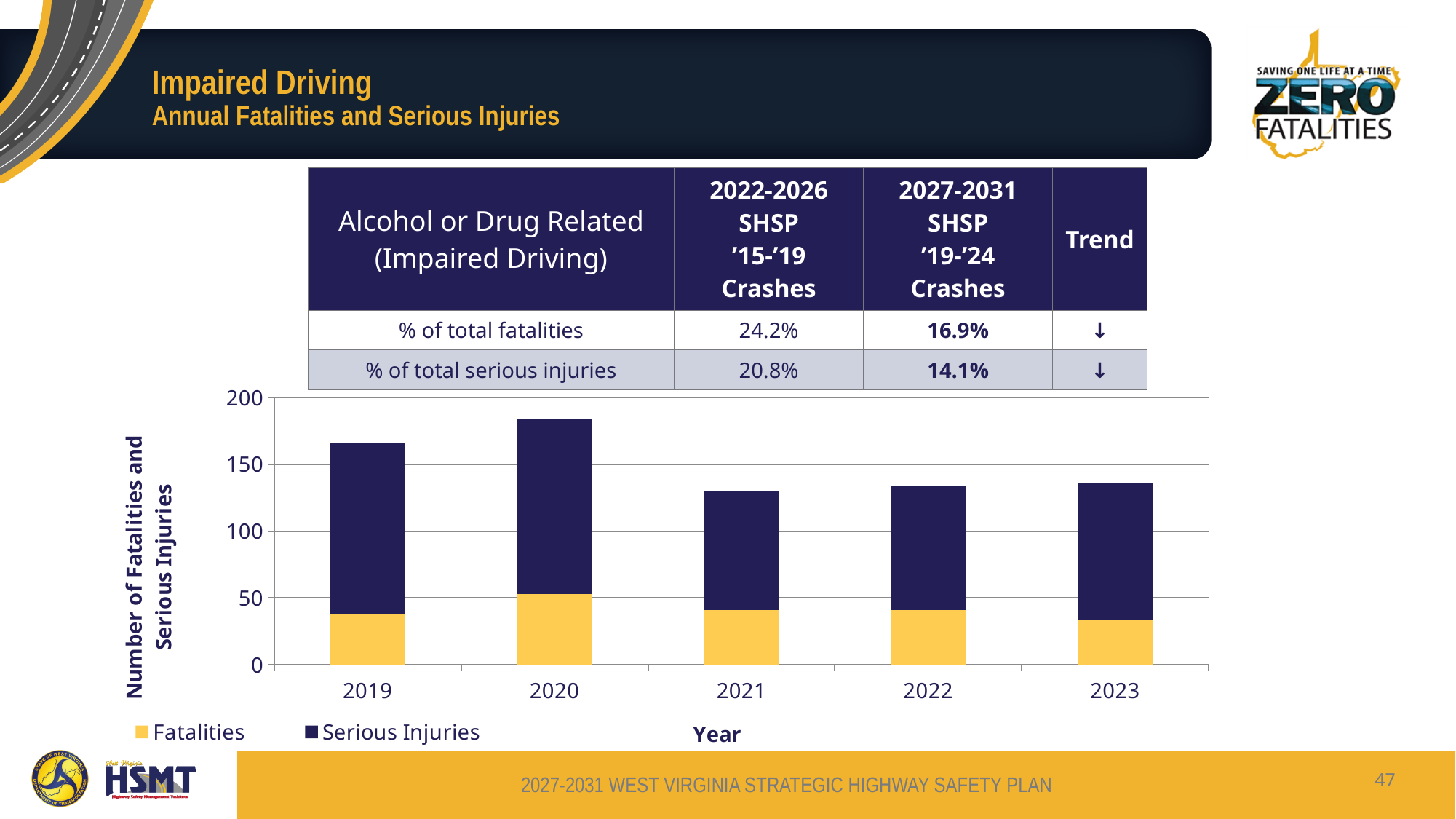
What kind of chart is shown on the slide? Stacked bar chart Which year has the tallest stacked bar (highest total of fatalities and serious injuries)? 2020 Is the number of fatalities in 2020 greater or less than 50? greater Which year has a larger total bar, 2019 or 2021? 2019 Which year has the highest number of fatalities? 2020 Is the number of fatalities in 2019 greater or less than 50? less How many years are shown on the x axis of the chart? 5 Does the total bar height rise or fall from 2020 to 2021? Fall Is the total bar height for 2020 greater or less than 150? greater How many series does the chart legend list? 2 Which colour represents Serious Injuries in the chart legend? Dark blue